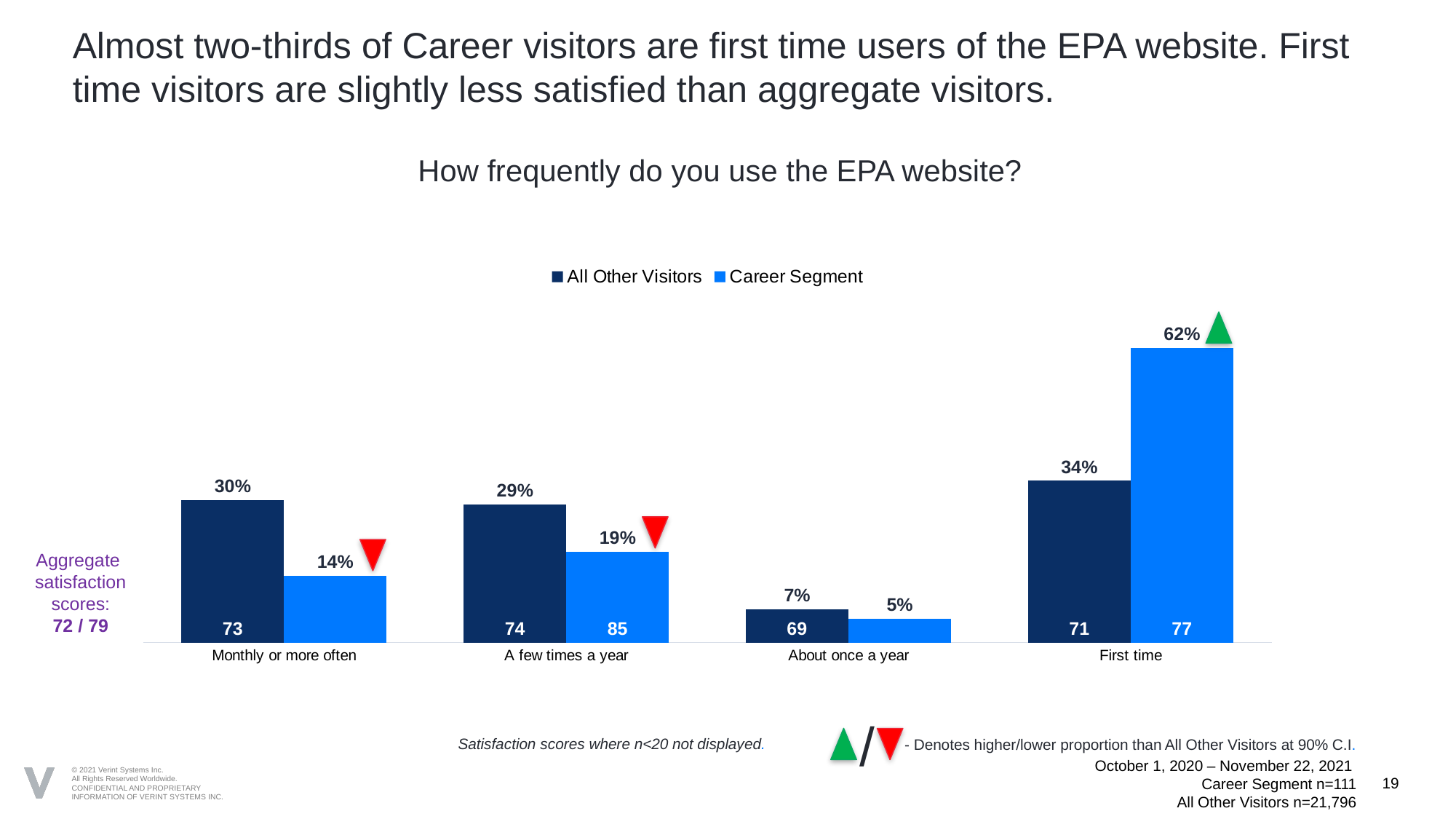
Which frequency category has the highest value for the Career Segment? First time What percentage of All Other Visitors use the EPA website monthly or more often? 30% What percentage of the Career Segment uses the EPA website a few times a year? 19% Which is larger for the Monthly or more often category: All Other Visitors or Career Segment? All Other Visitors What kind of chart is shown on the slide? Bar chart What question is the chart titled with? How frequently do you use the EPA website? What percentage of the Career Segment uses the EPA website for the first time? 62% How many frequency categories are shown on the x axis? 4 Which frequency category has the lowest value for All Other Visitors? About once a year How many series does the legend list? 2 What is the difference between the Career Segment and All Other Visitors for the First time category? 28 percentage points What is the satisfaction score shown inside the Career Segment bar for A few times a year? 85